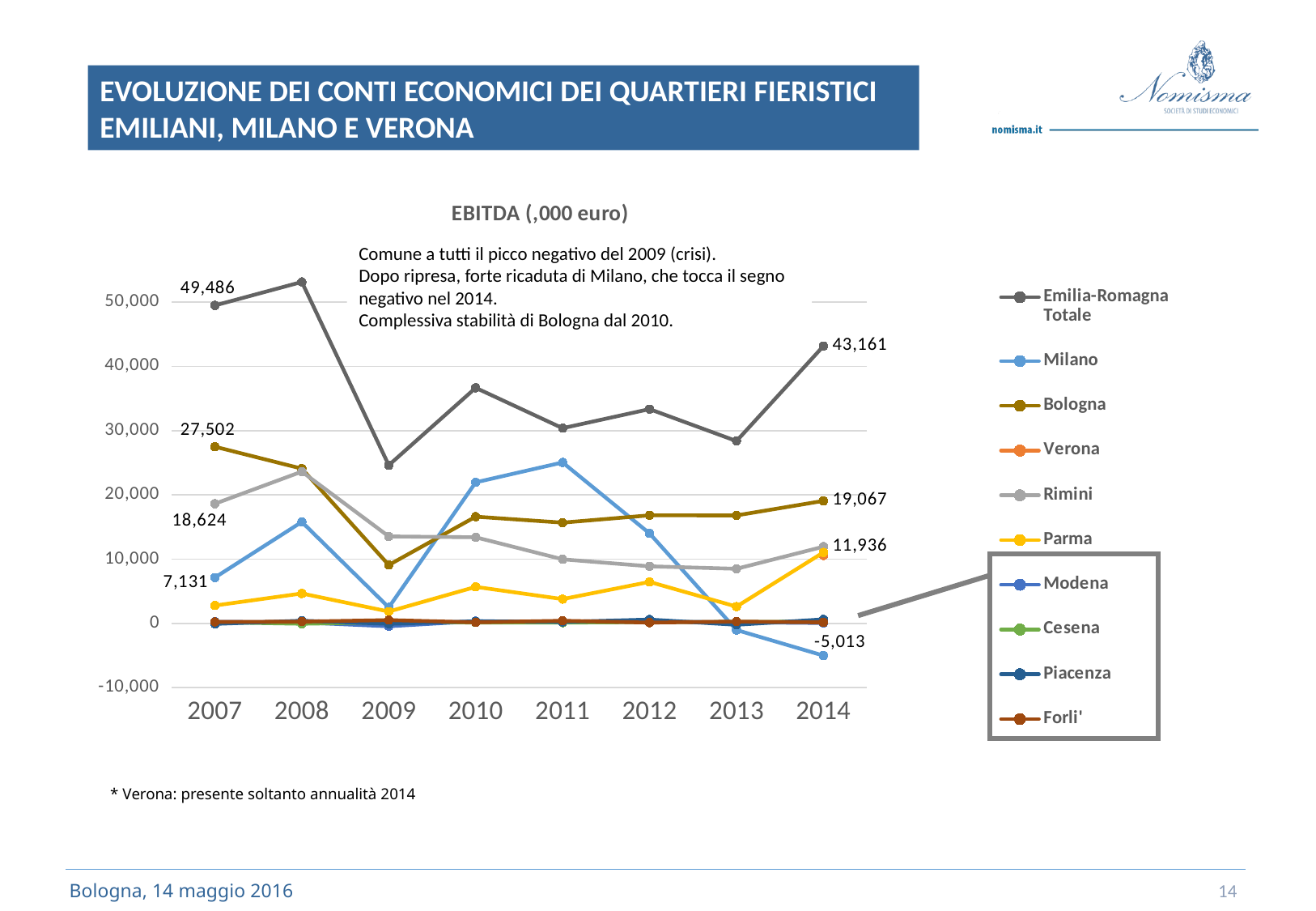
What is the value for Emilia-Romagna Totale in 2014? 43,161 How many series does the legend list? 10 What is the difference between the Bologna values in 2007 and 2014? 8,435 What is the value for Milano in 2014? -5,013 What is the difference between the Emilia-Romagna Totale values in 2007 and 2014? 6,325 What kind of chart is this? line chart Which is larger in 2007, Bologna or Rimini? Bologna What is the value for Bologna in 2007? 27,502 How many years are shown on the x axis? 8 What is the value for Emilia-Romagna Totale in 2007? 49,486 What is the value for Rimini in 2014? 11,936 Is the value for Milano in 2011 greater or less than 20,000? greater